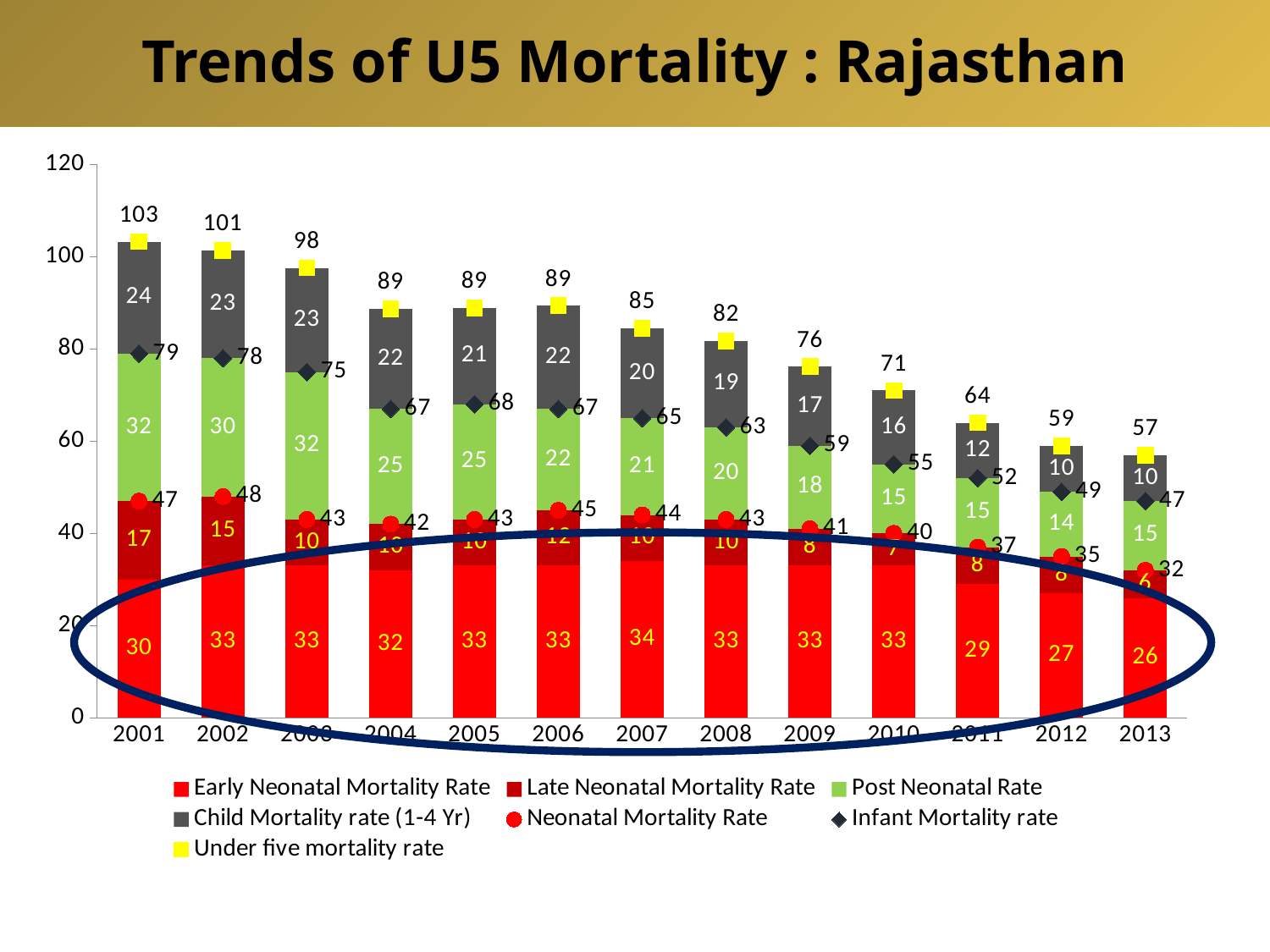
How many years are shown on the x axis? 13 Which year has the larger Post Neonatal Rate, 2001 or 2013? 2001 Which year has the highest Under five mortality rate? 2001 Does the Under five mortality rate rise or fall from 2001 to 2013? fall Which year has the lowest Under five mortality rate? 2013 What is the Under five mortality rate for 2001? 103 What is the difference between the Under five mortality rate in 2001 and in 2013? 46 What is the Infant Mortality rate for 2013? 47 What is the Neonatal Mortality Rate for 2002? 48 How many series does the legend list? 7 What is the Early Neonatal Mortality Rate value for 2007? 34 What is the Child Mortality rate (1-4 Yr) value for 2001? 24